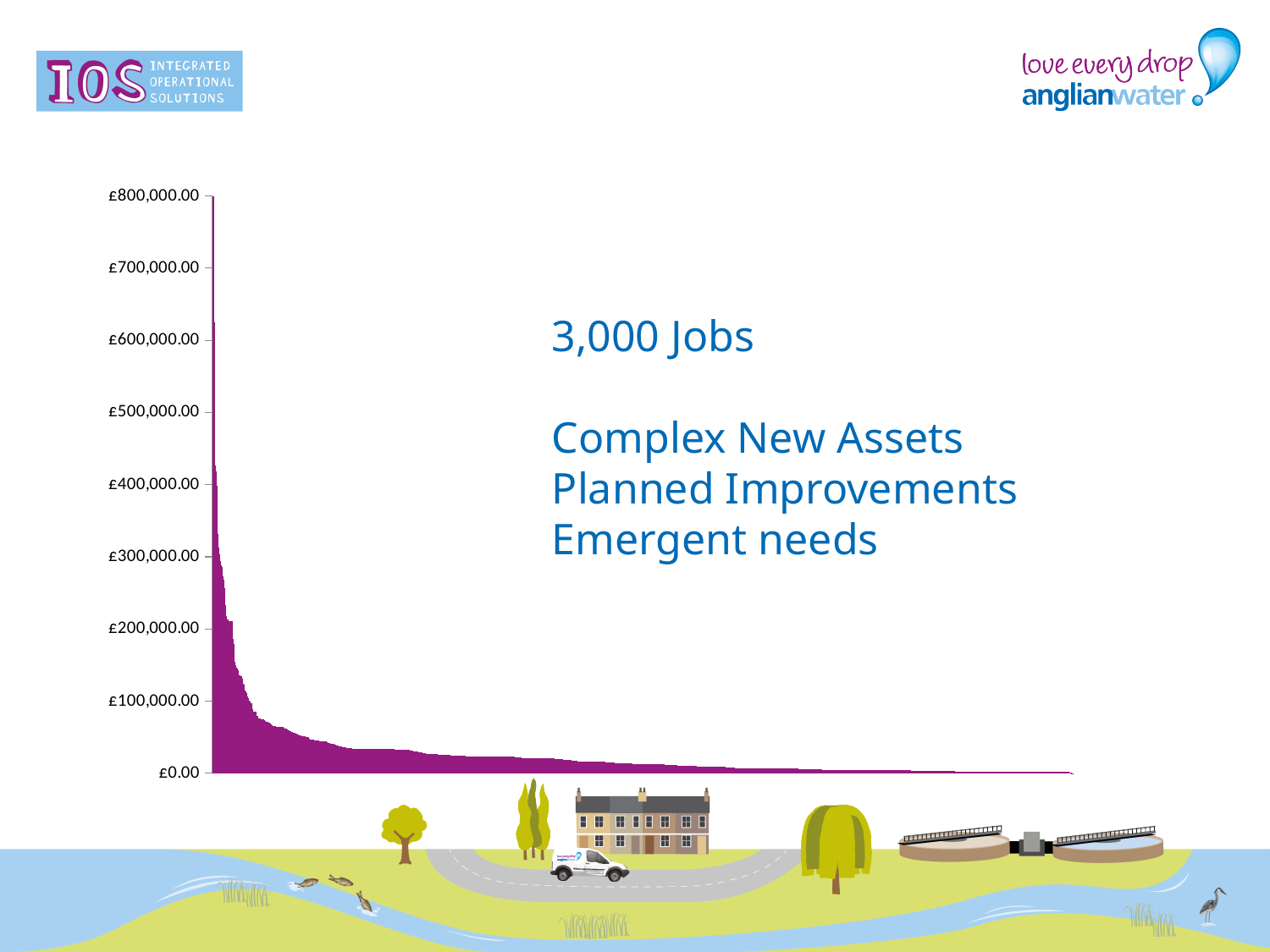
Do the plotted values rise or fall moving from left to right along the x axis? fall What is the lowest value shown on the chart's vertical axis? £0.00 Are the plotted values at the far right of the chart greater or less than £100,000.00? less What is the highest value shown on the chart's vertical axis? £800,000.00 Is the highest plotted value on the chart greater or less than £700,000.00? greater What colour is the plotted data on the chart? purple How many tick labels are shown on the chart's vertical axis? 9